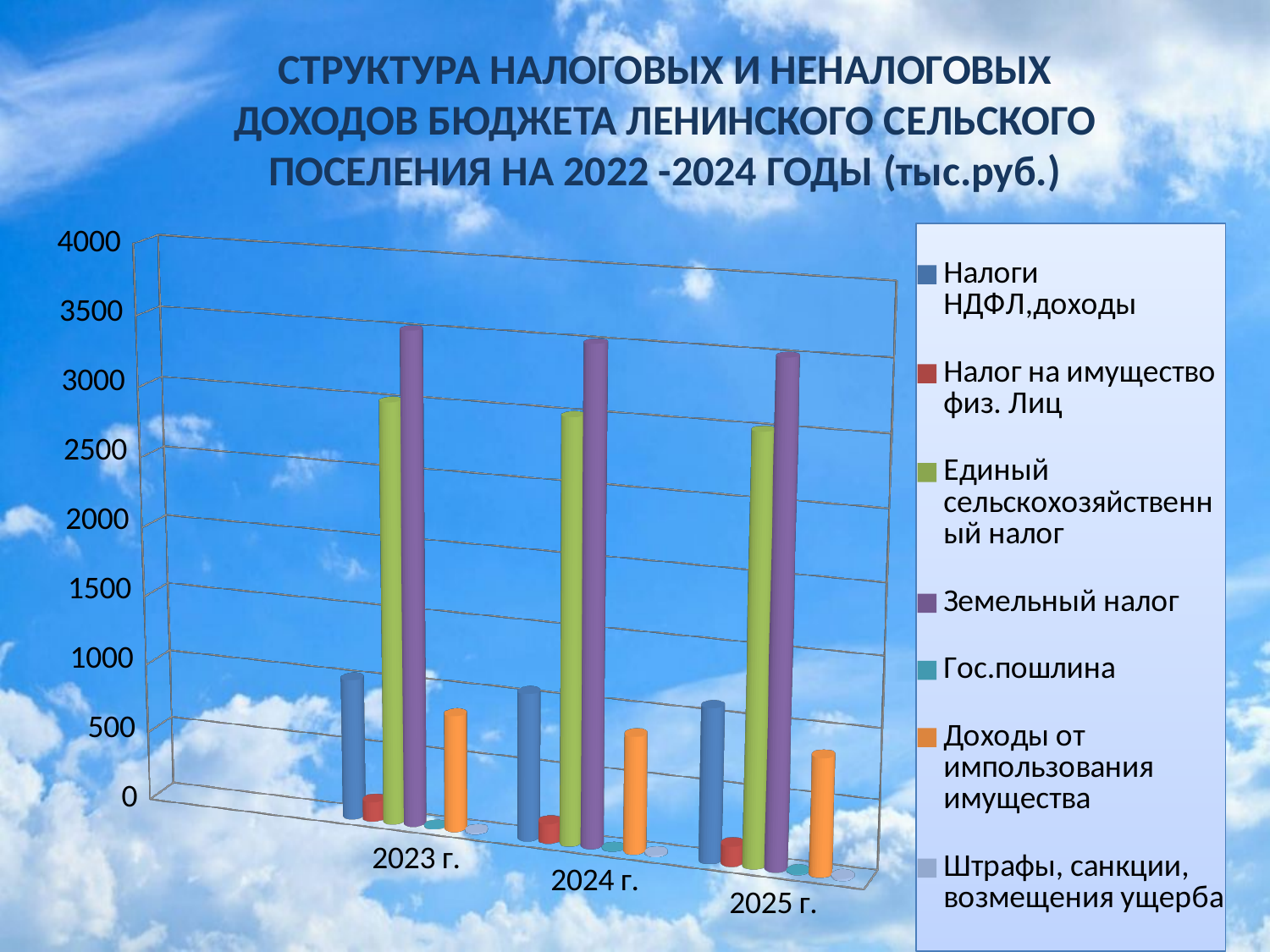
Is the value for Доходы от импользования имущества in 2025 г. greater or less than 500? greater Which series has the lowest value in 2024 г.? Гос.пошлина How many year categories are shown on the x axis? 3 What is the last year label shown on the x axis? 2025 г. Which series has the highest value in 2025 г.? Земельный налог How many series does the legend list? 7 Which series has the highest value in 2023 г.? Земельный налог Is the value for Земельный налог in 2023 г. greater or less than 3000? greater In 2024 г., which is larger: Земельный налог or Единый сельскохозяйственный налог? Земельный налог What kind of chart is shown on the slide? Bar chart